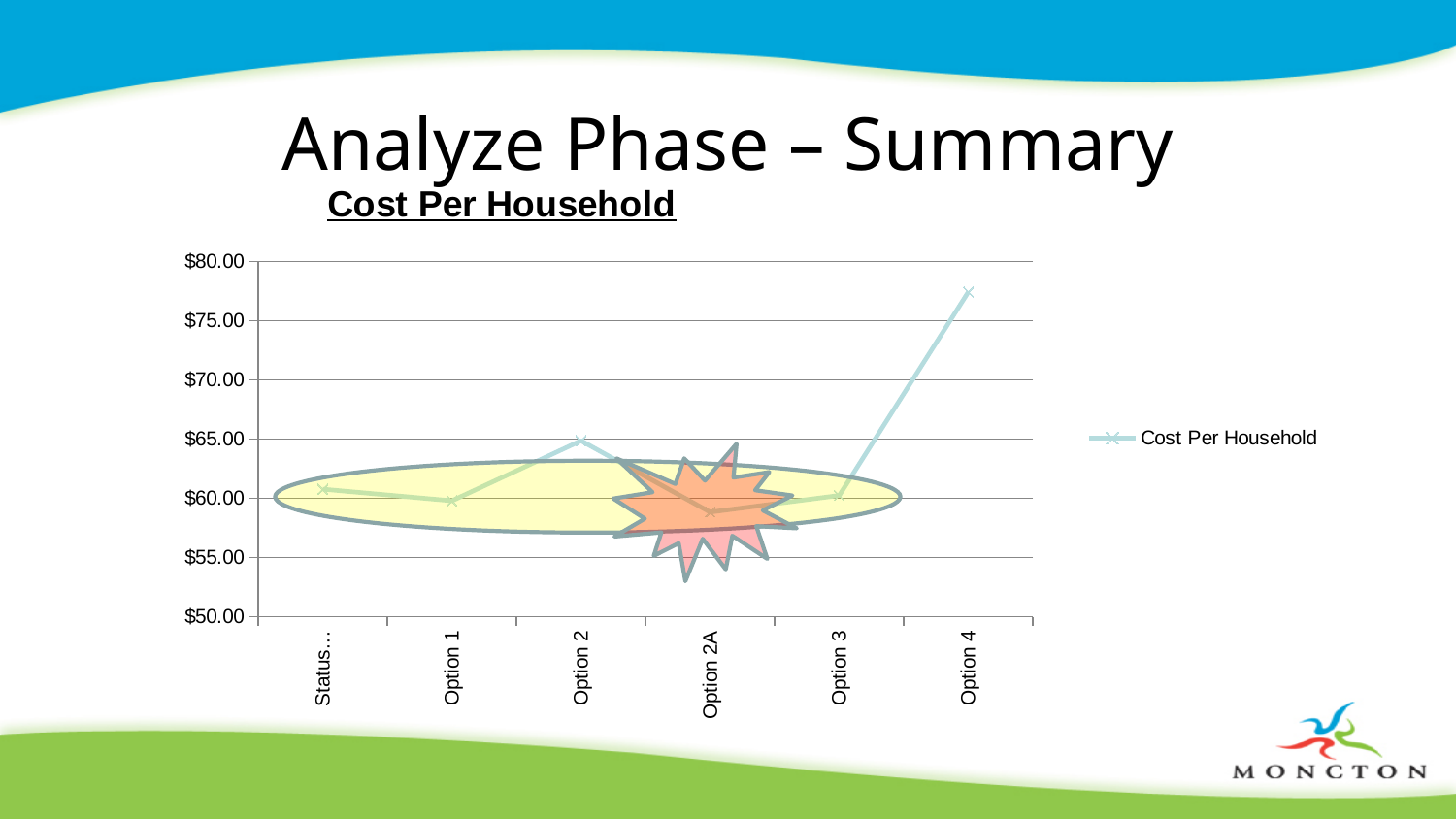
Which has a higher cost per household, Option 4 or Option 2? Option 4 Which category has the highest cost per household? Option 4 Does the cost per household rise or fall from Option 3 to Option 4? rise How many series does the chart's legend list? 1 How many categories are plotted along the x axis of the chart? 6 Is the value for Option 4 greater or less than $75.00? greater Is the value for Option 2A greater or less than $60.00? less Is the value for Option 2 greater or less than $60.00? greater Which has a higher cost per household, Option 2 or Option 3? Option 2 What is the name of the series shown in the legend? Cost Per Household Which category has the lowest cost per household? Option 2A What kind of chart is shown on the slide? line chart